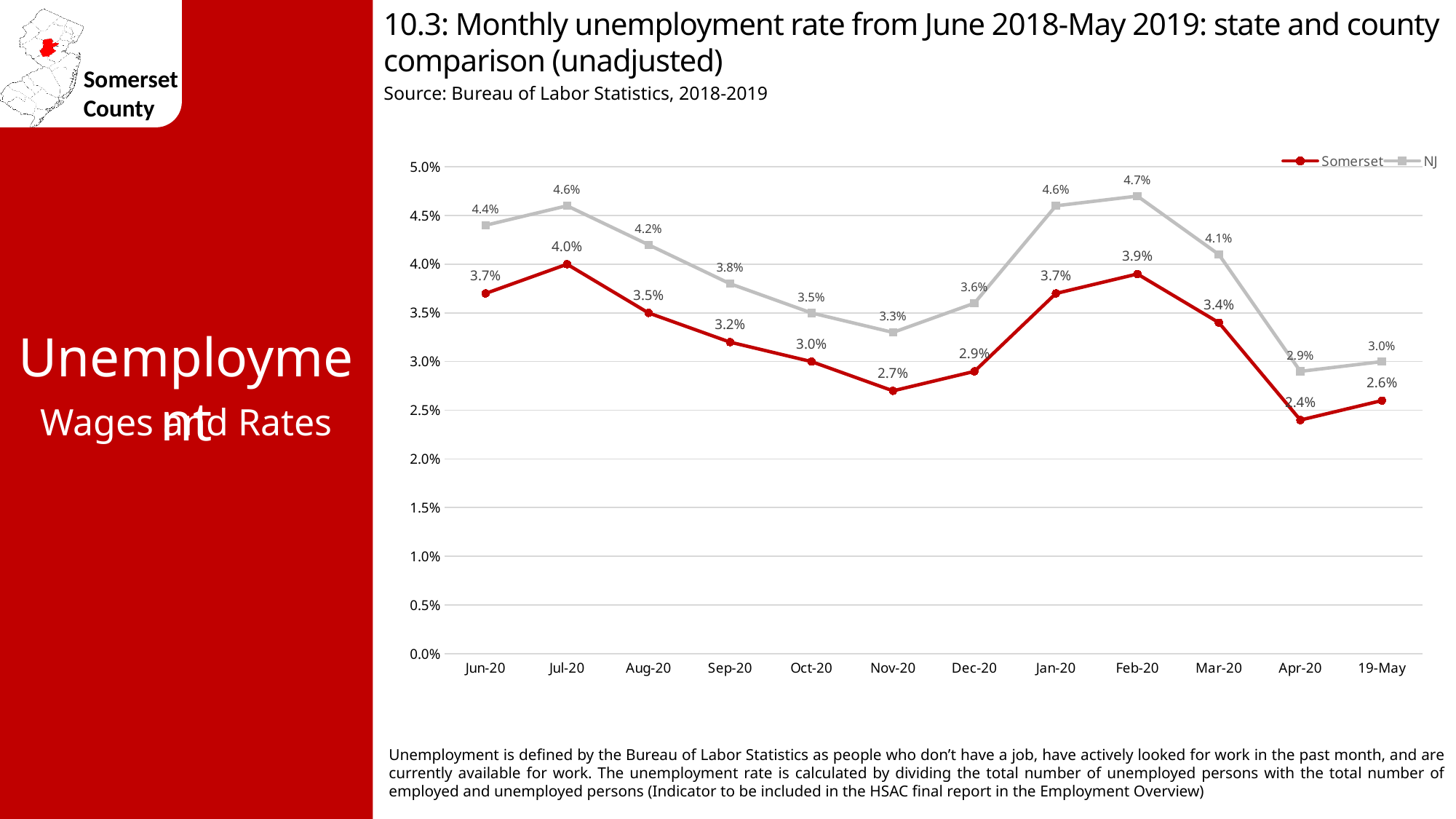
In which month is the Somerset unemployment rate lowest? Apr-20 What is the NJ unemployment rate for Apr-20? 2.9% What is the difference between the NJ and Somerset unemployment rates in Jan-20? 0.9% Which series has the higher unemployment rate in Sep-20, Somerset or NJ? NJ How many series does the legend list? 2 Does the Somerset unemployment rate rise or fall from Feb-20 to Apr-20? Fall What is the Somerset unemployment rate for Jul-20? 4.0% What is the Somerset unemployment rate for Nov-20? 2.7% In which month is the NJ unemployment rate highest? Feb-20 What is the NJ unemployment rate for Feb-20? 4.7% How many months are plotted on the x axis? 12 What kind of chart is shown on the slide? Line chart